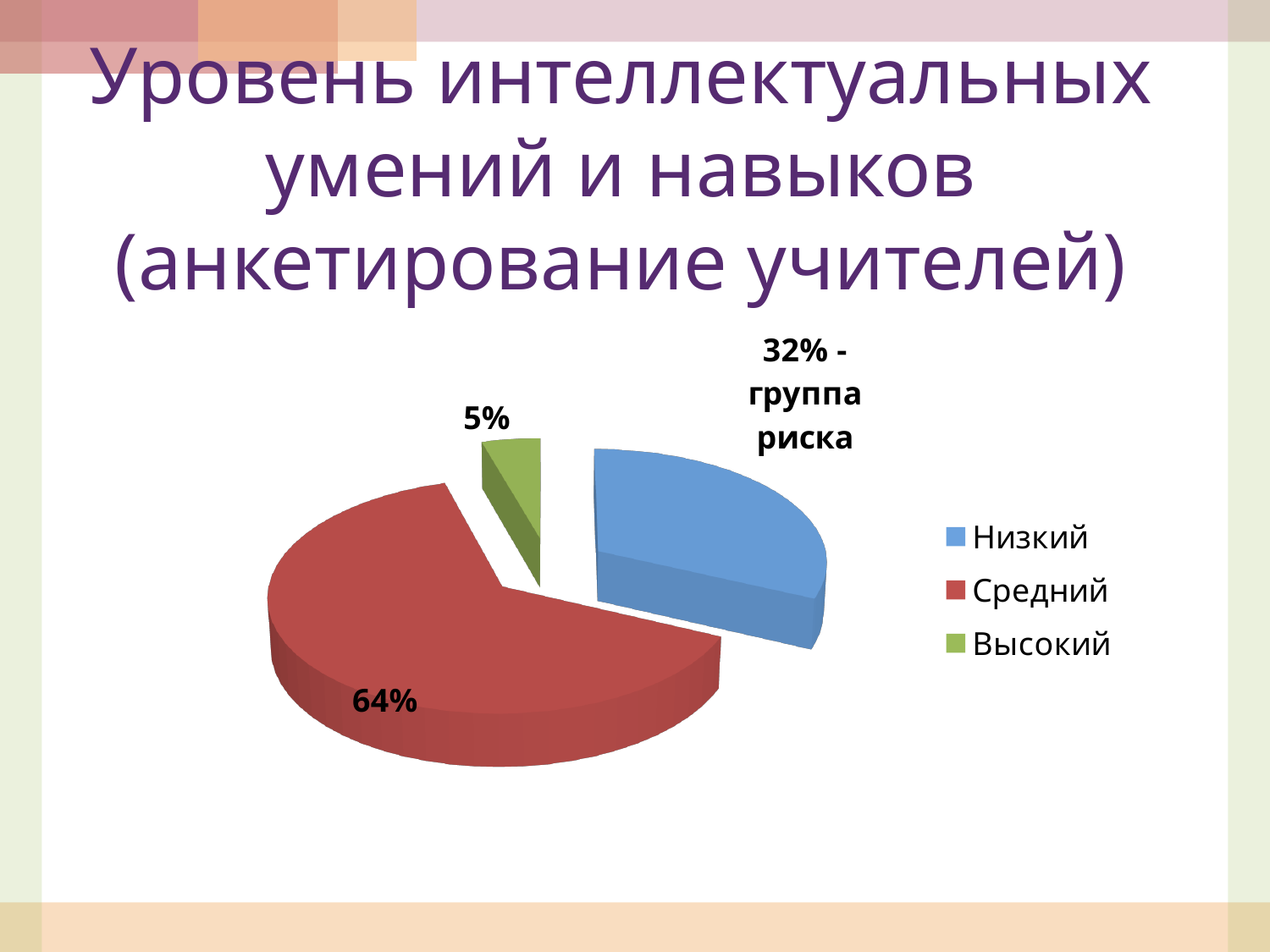
How many slices does the pie chart have? 3 Which category has the smallest slice of the pie? Высокий What kind of chart is shown on the slide? pie chart Which category is labelled as 'группа риска' on the chart? Низкий What share of the pie does the Средний slice have? 64% Which slice is larger, Низкий or Высокий? Низкий Which category has the largest slice of the pie? Средний What share of the pie does the Высокий slice have? 5% What share of the pie does the Низкий slice have? 32% How many entries does the legend list? 3 What is the difference in percentage points between the Средний and Низкий slices? 32 What colour is the Средний slice? red